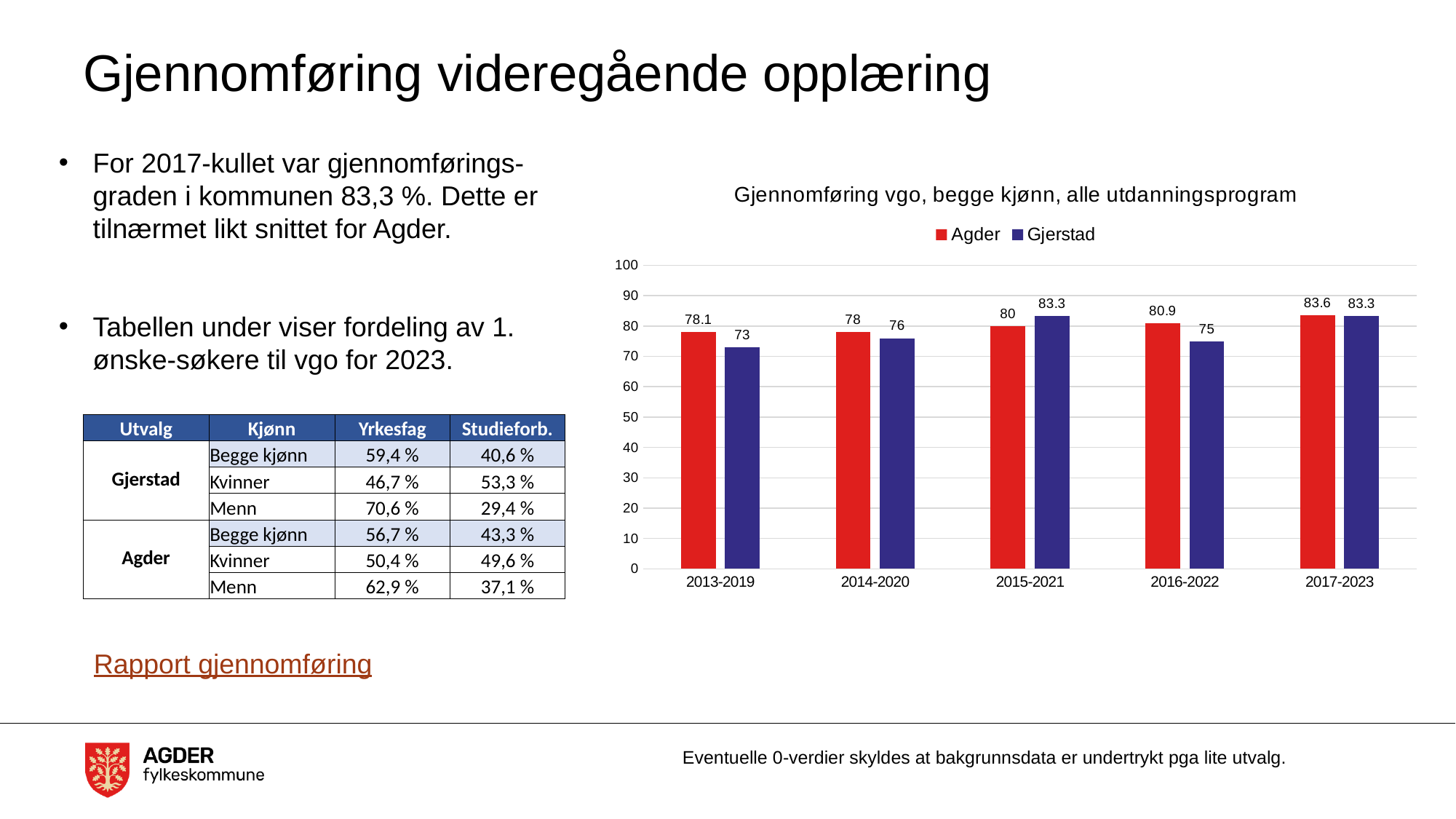
What kind of chart is shown? bar chart What is the value for Agder in 2016-2022? 80.9 What is the value for Gjerstad in 2015-2021? 83.3 Which is larger in 2014-2020, Agder or Gjerstad? Agder What is the value for Gjerstad in 2013-2019? 73 In which period is the Agder value highest? 2017-2023 In which period is the Gjerstad value lowest? 2013-2019 How many periods are shown on the x axis? 5 What is the title of the chart? Gjennomføring vgo, begge kjønn, alle utdanningsprogram What is the difference between Agder and Gjerstad in 2016-2022? 5.9 How many series does the legend list? 2 Is the value for Gjerstad in 2016-2022 greater or less than 80? less